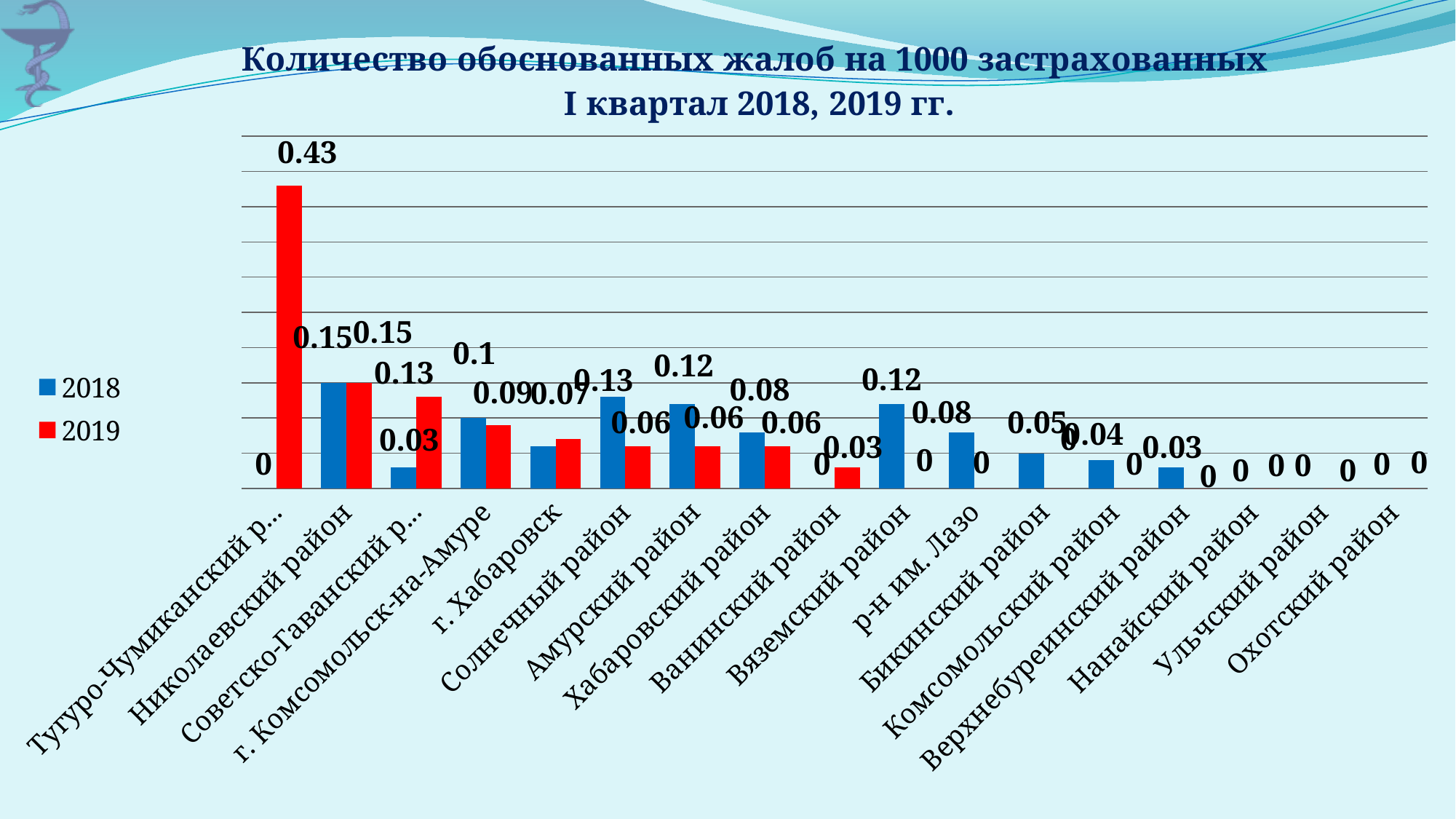
What is the difference between the 2018 and 2019 values for Амурский район? 0.06 What is the 2019 value for Советско-Гаванский район? 0.13 How many categories are shown on the x axis? 17 How many series does the legend list? 2 What is the 2019 value for Тугуро-Чумиканский район? 0.43 Which category has the highest 2019 value? Тугуро-Чумиканский район What is the difference between the 2019 and 2018 values for Советско-Гаванский район? 0.1 What kind of chart is shown on the slide? Bar chart Which is larger for Вяземский район, the 2018 value or the 2019 value? 2018 Which is larger for Ванинский район, the 2018 value or the 2019 value? 2019 What is the 2018 value for Вяземский район? 0.12 What is the 2018 value for Солнечный район? 0.13